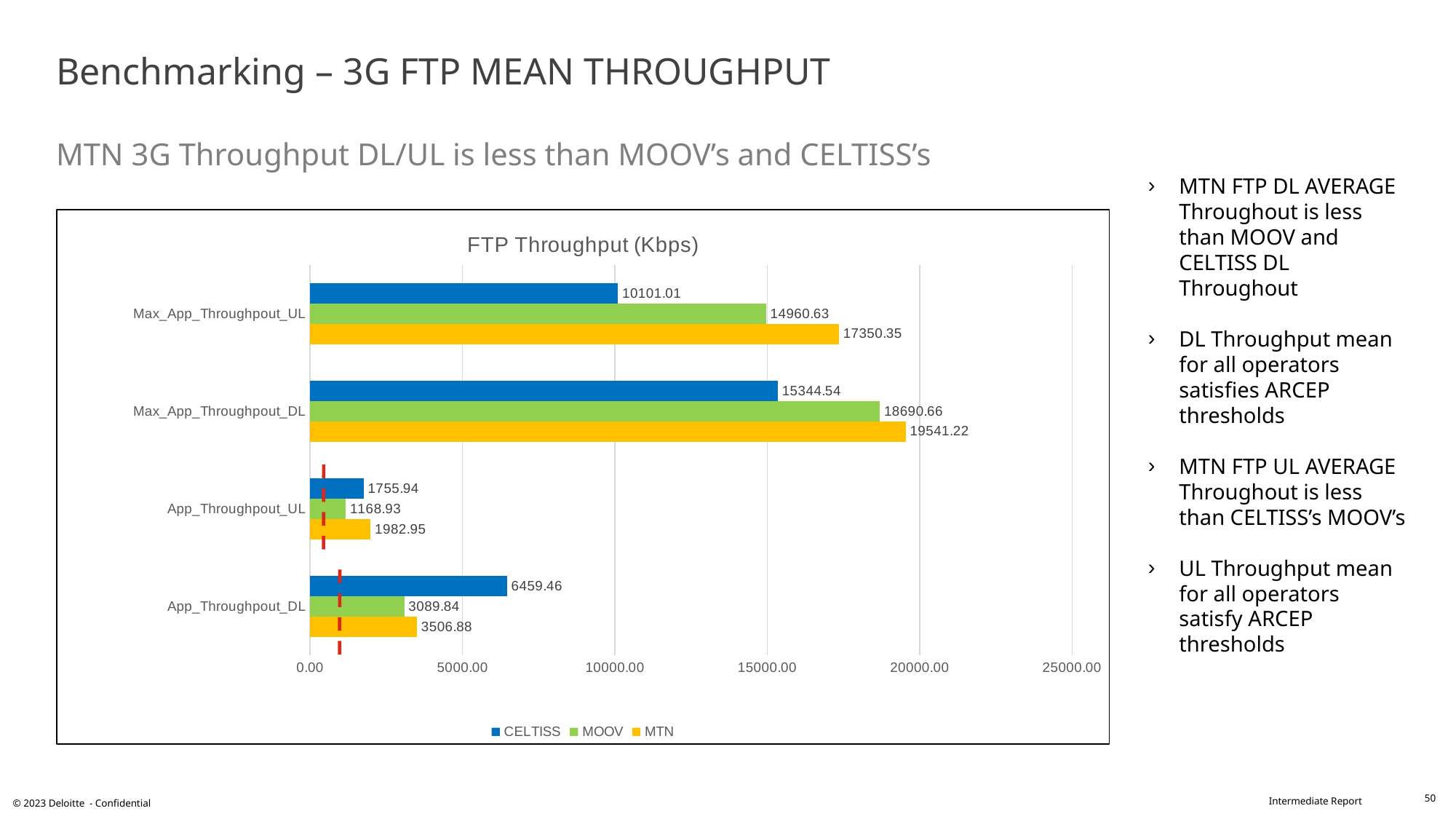
Which operator has the lowest value for App_Throughpout_UL? MOOV How many series does the legend list? 3 What is the difference between the MTN and CELTISS values for Max_App_Throughpout_DL? 4196.68 What is the CELTISS value for App_Throughpout_DL? 6459.46 What type of chart is shown on the slide? Bar chart For Max_App_Throughpout_UL, which is larger: the CELTISS value or the MOOV value? MOOV What is the MTN value for Max_App_Throughpout_DL? 19541.22 What is the title of the chart? FTP Throughput (Kbps) Which operator has the highest value for App_Throughpout_DL? CELTISS Is the CELTISS value for Max_App_Throughpout_UL greater or less than 10000.00? greater How many categories are shown on the chart? 4 What is the MOOV value for Max_App_Throughpout_UL? 14960.63